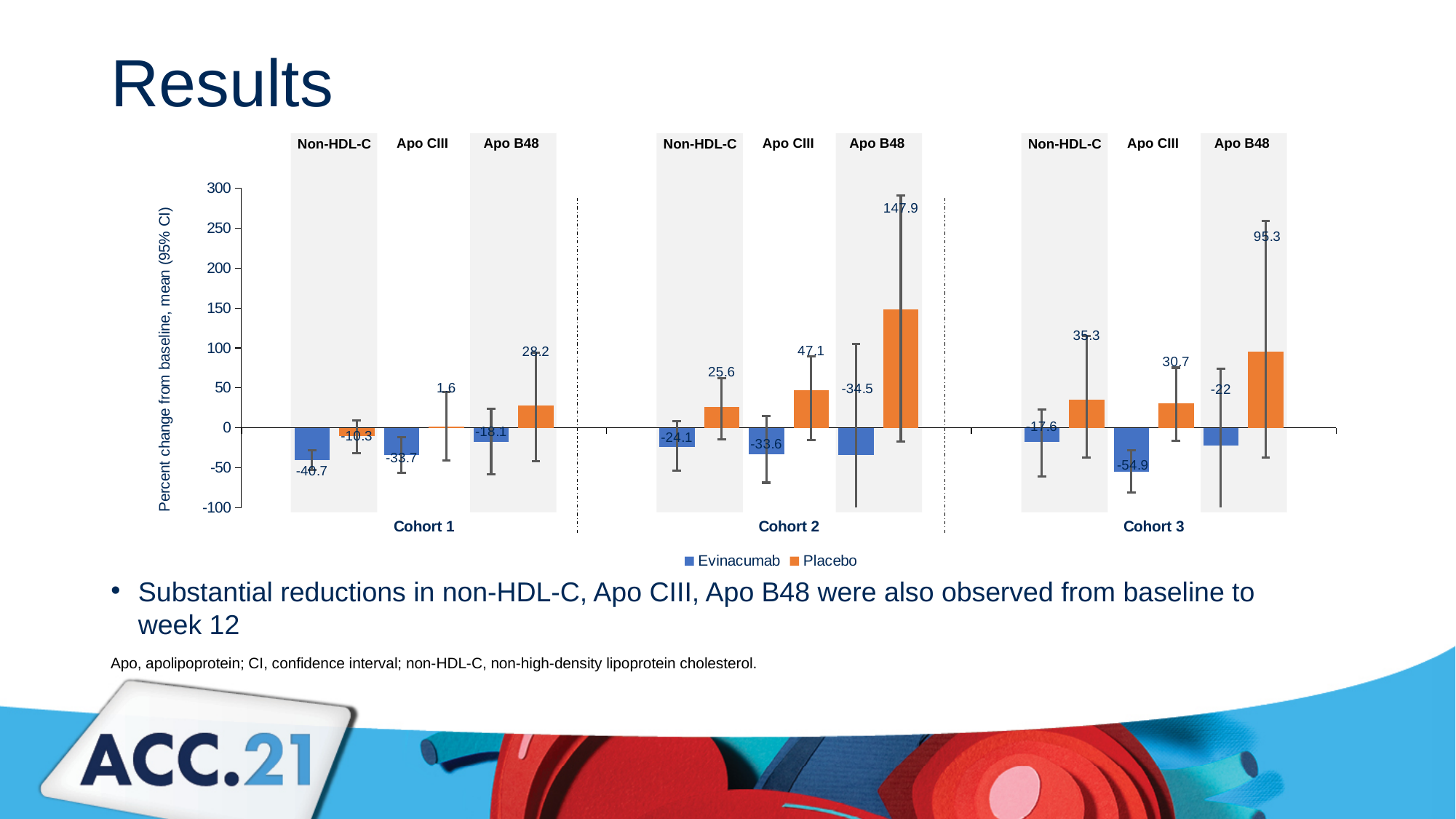
Which colour represents Placebo in the chart? Orange Which is larger: the Placebo mean percent change for Apo CIII in Cohort 2 or for Apo CIII in Cohort 3? Apo CIII in Cohort 2 What is the mean percent change from baseline for Placebo in Apo CIII in Cohort 1? 1.6 Is the Placebo mean percent change for Apo B48 in Cohort 2 greater or less than 100? greater What is the mean percent change from baseline for Placebo in Apo B48 in Cohort 2? 147.9 How many series does the legend list? 2 Which bar shows the highest mean percent change from baseline on the chart? Placebo, Apo B48, Cohort 2 What is the mean percent change from baseline for Evinacumab in Apo CIII in Cohort 3? -54.9 What is the mean percent change from baseline for Evinacumab in Non-HDL-C in Cohort 1? -40.7 What kind of chart is shown on the slide? Bar chart Which bar shows the lowest mean percent change from baseline on the chart? Evinacumab, Apo CIII, Cohort 3 What is the difference between the Placebo and Evinacumab mean percent change for Apo B48 in Cohort 3? 117.3